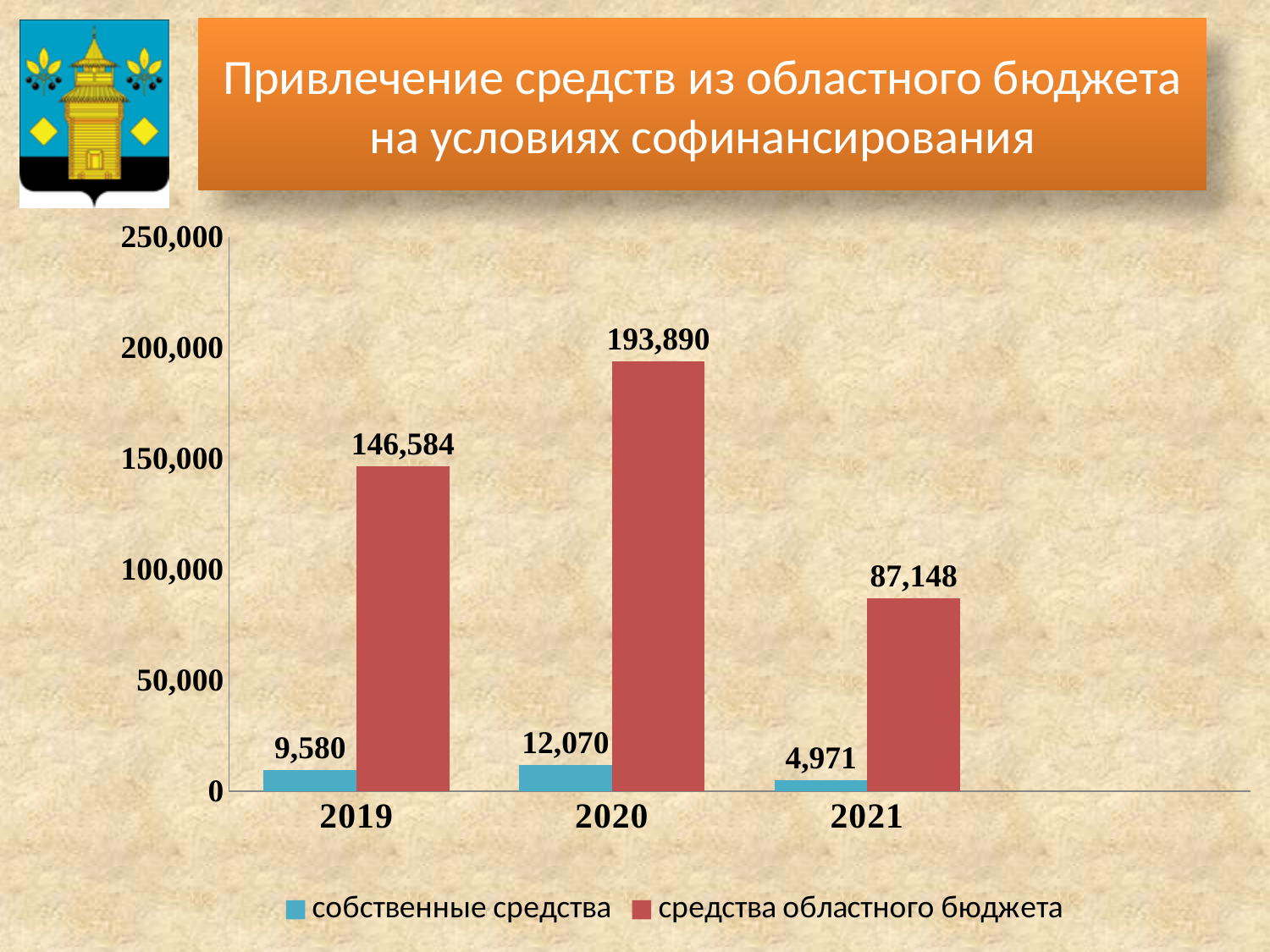
Which is larger: собственные средства in 2020 or in 2019? 2020 In which year is собственные средства lowest? 2021 In which year is средства областного бюджета highest? 2020 How many years are shown on the x axis? 3 How many series does the legend list? 2 Is the value for средства областного бюджета in 2021 greater or less than 100,000? less What is the difference between средства областного бюджета in 2020 and 2019? 47,306 What is the value of средства областного бюджета for 2020? 193,890 What is the value of средства областного бюджета for 2021? 87,148 What is the value of собственные средства for 2021? 4,971 What is the value of собственные средства for 2019? 9,580 What kind of chart is shown on the slide? bar chart